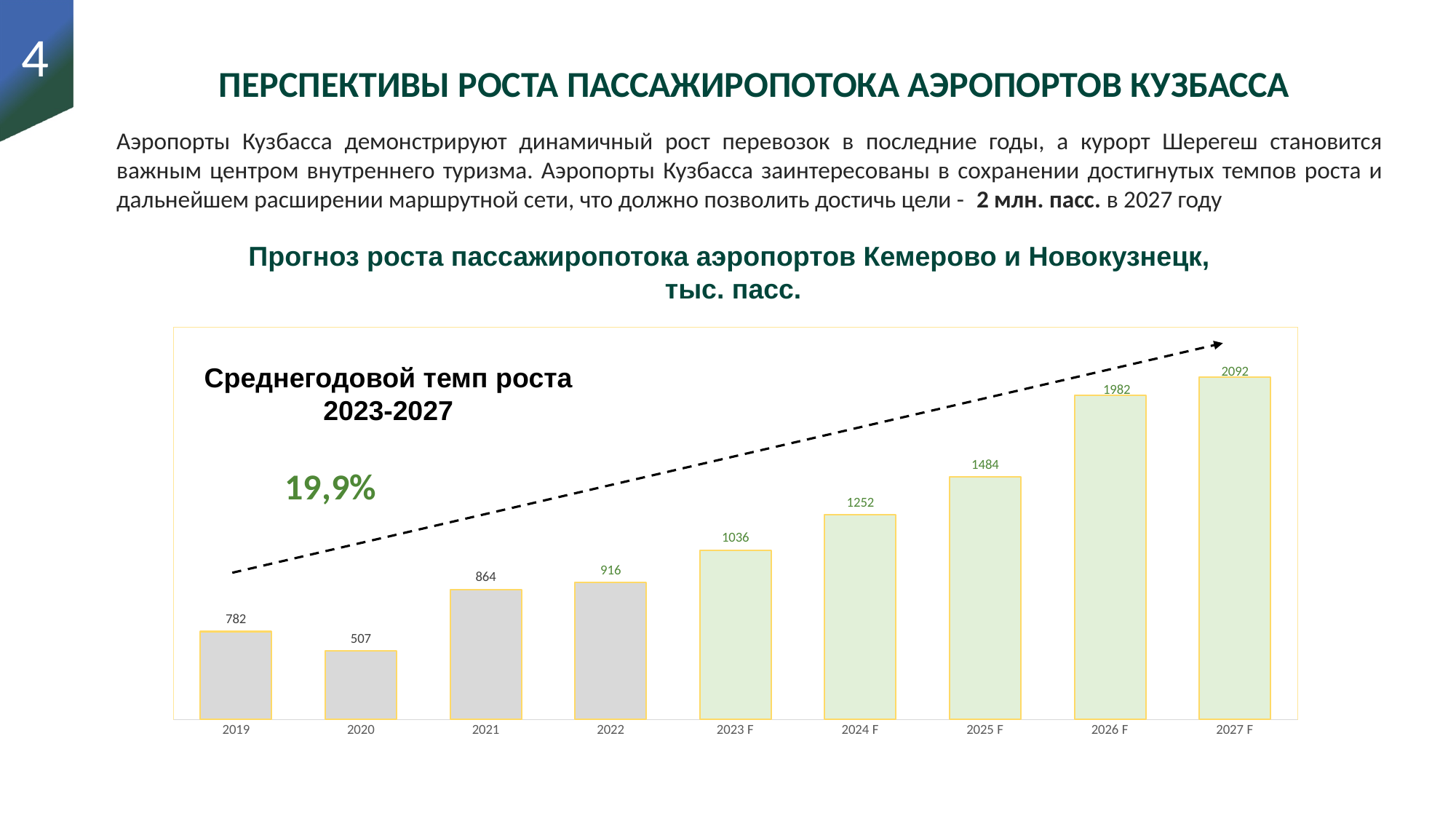
What is the value for 2024 F? 1252 Which year has the lowest value? 2020 What is the value for 2027 F? 2092 How many years are shown on the x axis? 9 Which is larger, the value for 2022 or the value for 2023 F? 2023 F What kind of chart is this? bar chart Which year has the highest value? 2027 F What average annual growth rate for 2023-2027 is shown on the chart? 19,9% What is the value for 2019? 782 What is the difference between the values for 2021 and 2020? 357 What is the value for 2020? 507 What is the difference between the values for 2027 F and 2026 F? 110